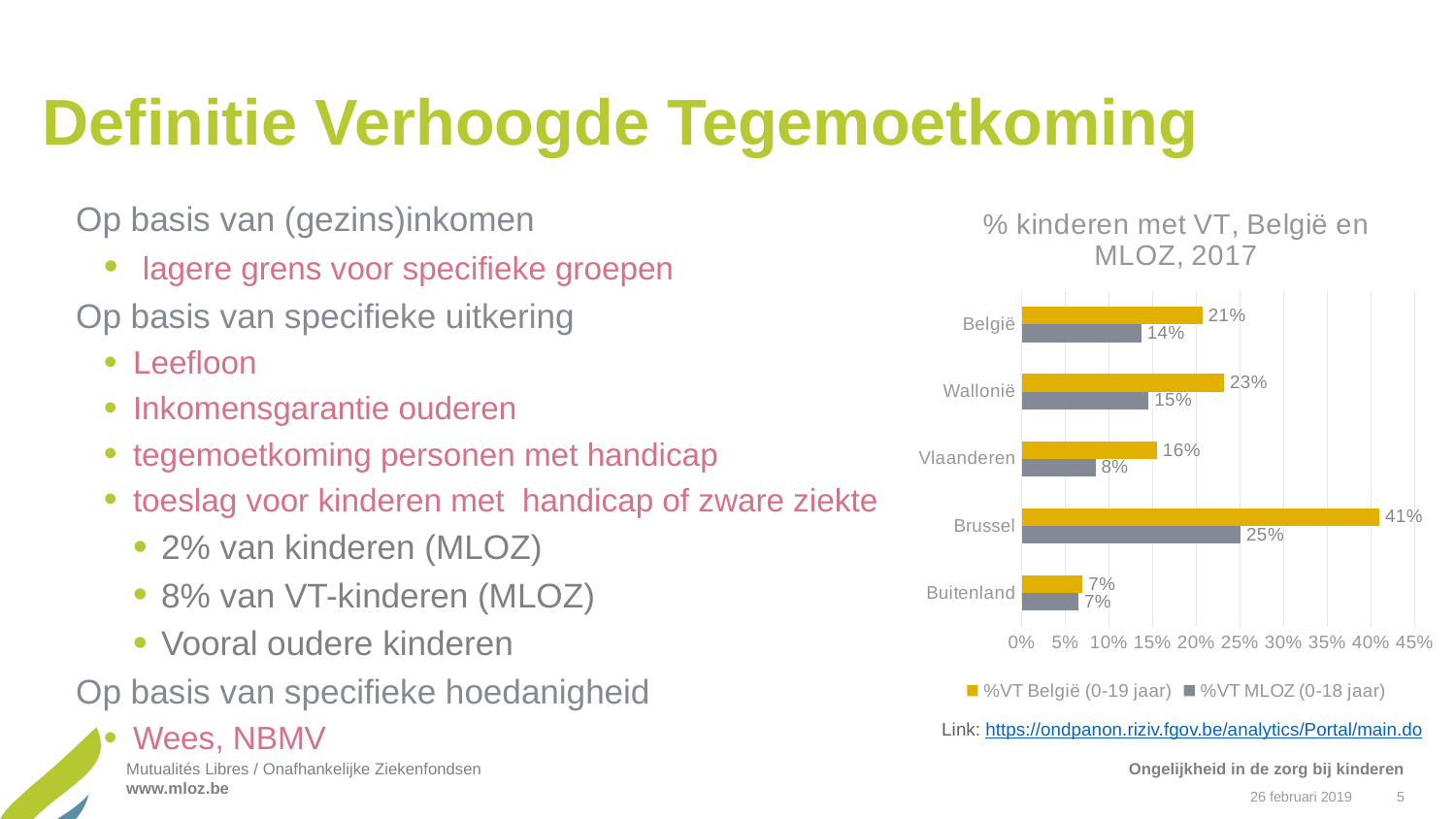
How many series does the legend list? 2 What is the difference between the %VT België (0-19 jaar) values for Wallonië and Vlaanderen? 7% What is the value for Brussel in the %VT België (0-19 jaar) series? 41% What is the difference between the %VT België (0-19 jaar) and %VT MLOZ (0-18 jaar) values for Brussel? 16% What is the value for Wallonië in the %VT België (0-19 jaar) series? 23% What kind of chart is shown on the slide? Bar chart Which is larger: the %VT MLOZ (0-18 jaar) value for Wallonië or for Vlaanderen? Wallonië What is the value for Vlaanderen in the %VT MLOZ (0-18 jaar) series? 8% Which category has the highest value in the %VT MLOZ (0-18 jaar) series? Brussel Which category has the lowest value in the %VT België (0-19 jaar) series? Buitenland What is the title of the chart? % kinderen met VT, België en MLOZ, 2017 How many categories are shown on the chart? 5